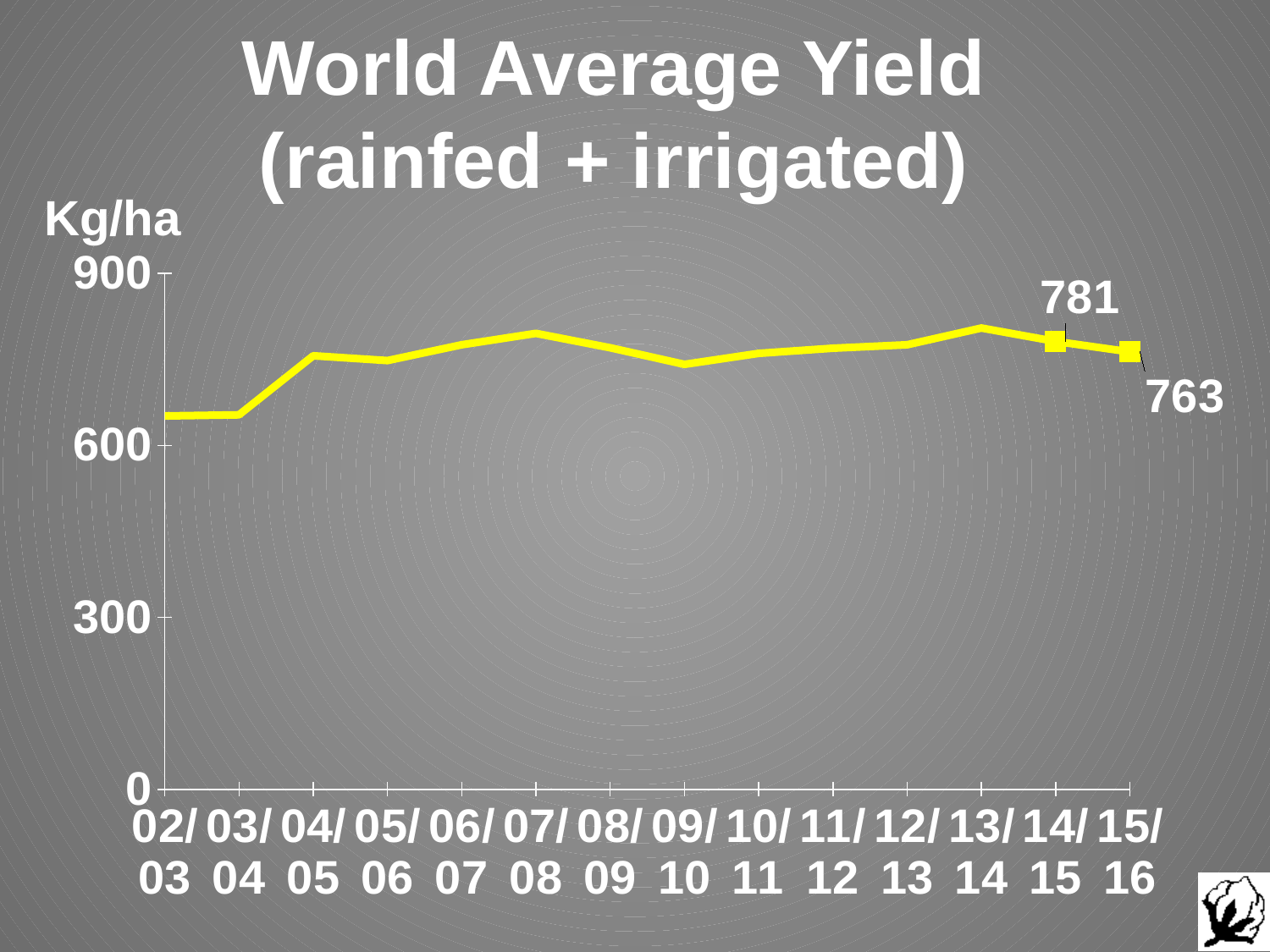
How many seasons are plotted on the x axis? 14 Which season has the higher yield, 03/04 or 04/05? 04/05 Is the value for 07/08 greater or less than 900? less What is the world average yield for 14/15? 781 Does the yield rise or fall from 02/03 to 04/05? rise What is the difference between the yield in 14/15 and the yield in 15/16? 18 What is the world average yield for 15/16? 763 Is the value for 02/03 greater or less than 600? greater What unit is shown on the y axis? Kg/ha What kind of chart is shown on the slide? line chart Which year has the higher yield, 14/15 or 15/16? 14/15 Which season has the higher yield, 07/08 or 09/10? 07/08